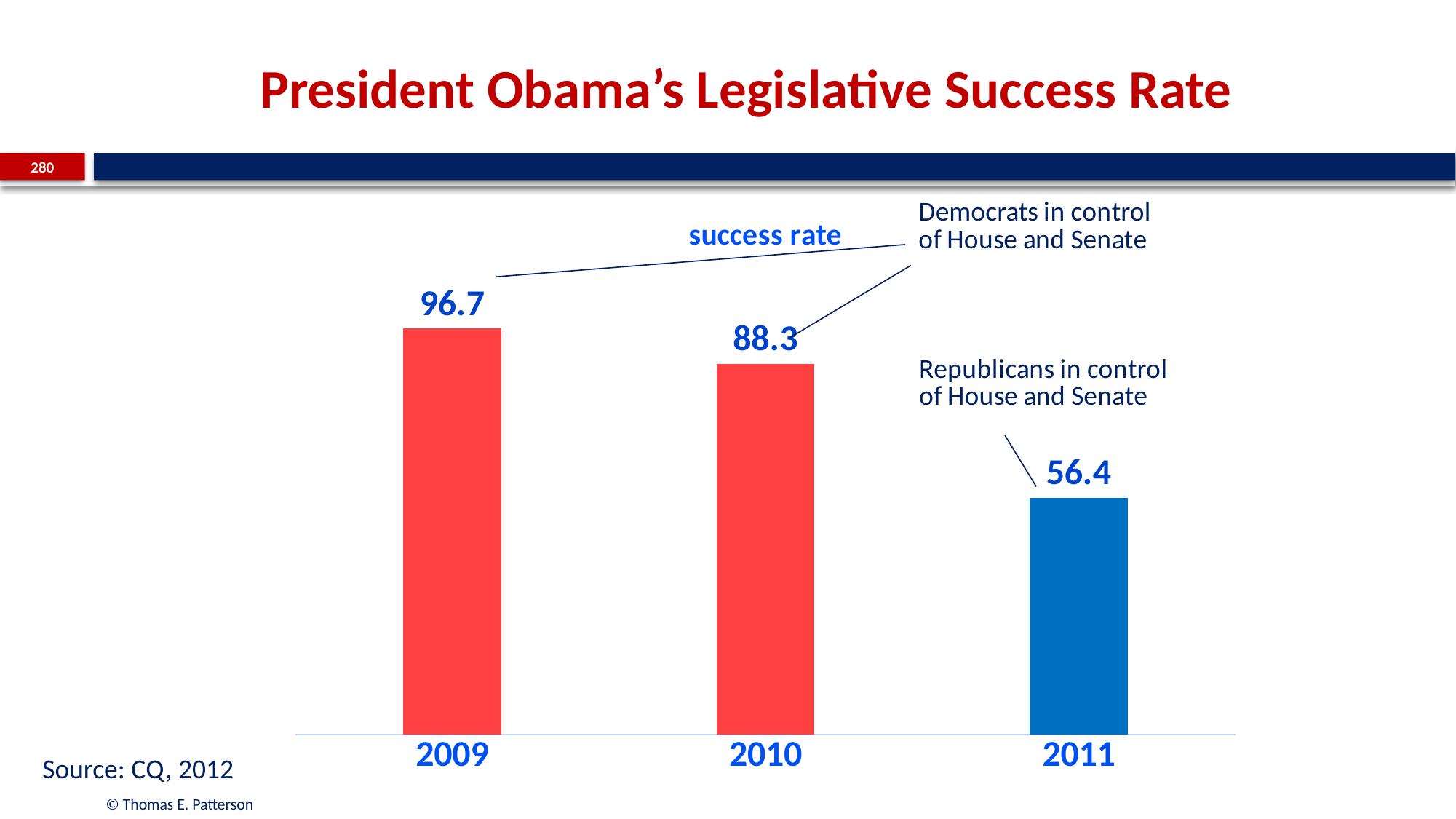
What is the success rate for 2011? 56.4 Which year has a higher success rate, 2010 or 2011? 2010 What kind of chart is shown on the slide? Bar chart What is the success rate for 2010? 88.3 What is the success rate for 2009? 96.7 Does the success rate rise or fall from 2009 to 2011? Fall Which year has the highest success rate? 2009 What is the difference between the success rates for 2009 and 2011? 40.3 What is the difference between the success rates for 2009 and 2010? 8.4 Which year has the lowest success rate? 2011 How many years are shown in the chart? 3 What is the title of the chart? President Obama's Legislative Success Rate